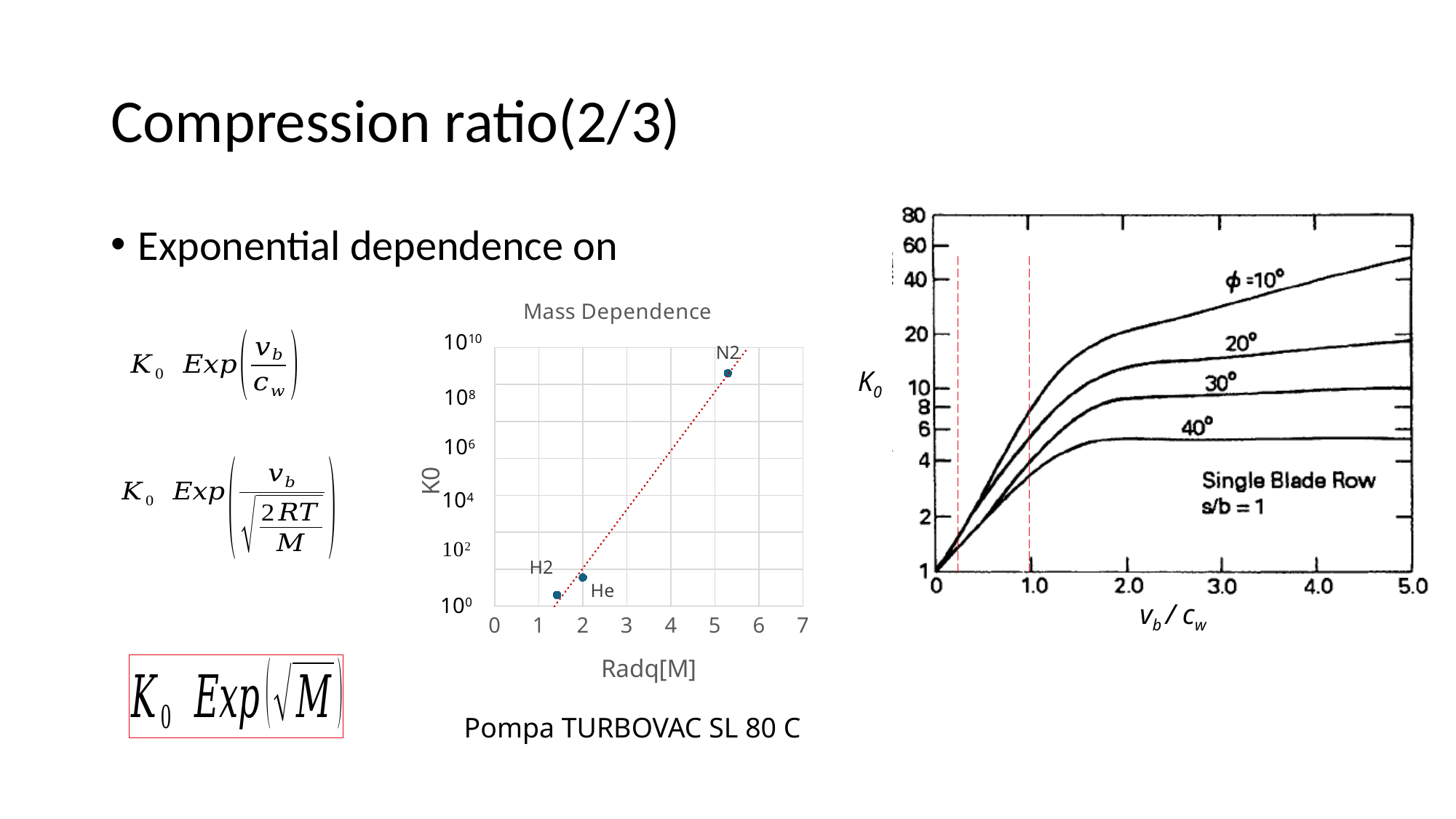
In the right-hand chart of K0 versus vb/cw, what value of s/b is stated on the chart? s/b = 1 In the Mass Dependence chart, is the K0 value for He greater or less than 10^2? less In the right-hand chart of K0 versus vb/cw, is the K0 value of the 40° curve at vb/cw = 4.0 greater or less than 10? less In the Mass Dependence chart, is the K0 value for N2 greater or less than 10^8? greater In the right-hand chart of K0 versus vb/cw, which blade angle curve reaches the highest K0 at vb/cw = 5.0? φ = 10° In the Mass Dependence chart, which labelled point has the highest K0 value? N2 In the Mass Dependence chart, does K0 rise or fall as Radq[M] increases? Rises In the right-hand chart of K0 versus vb/cw, how many blade-angle curves are plotted? 4 How many data points are plotted in the Mass Dependence chart? 3 In the Mass Dependence chart, which labelled point has the lowest K0 value? H2 What kind of chart is the Mass Dependence chart? Scatter chart What is the x-axis label of the Mass Dependence chart? Radq[M]